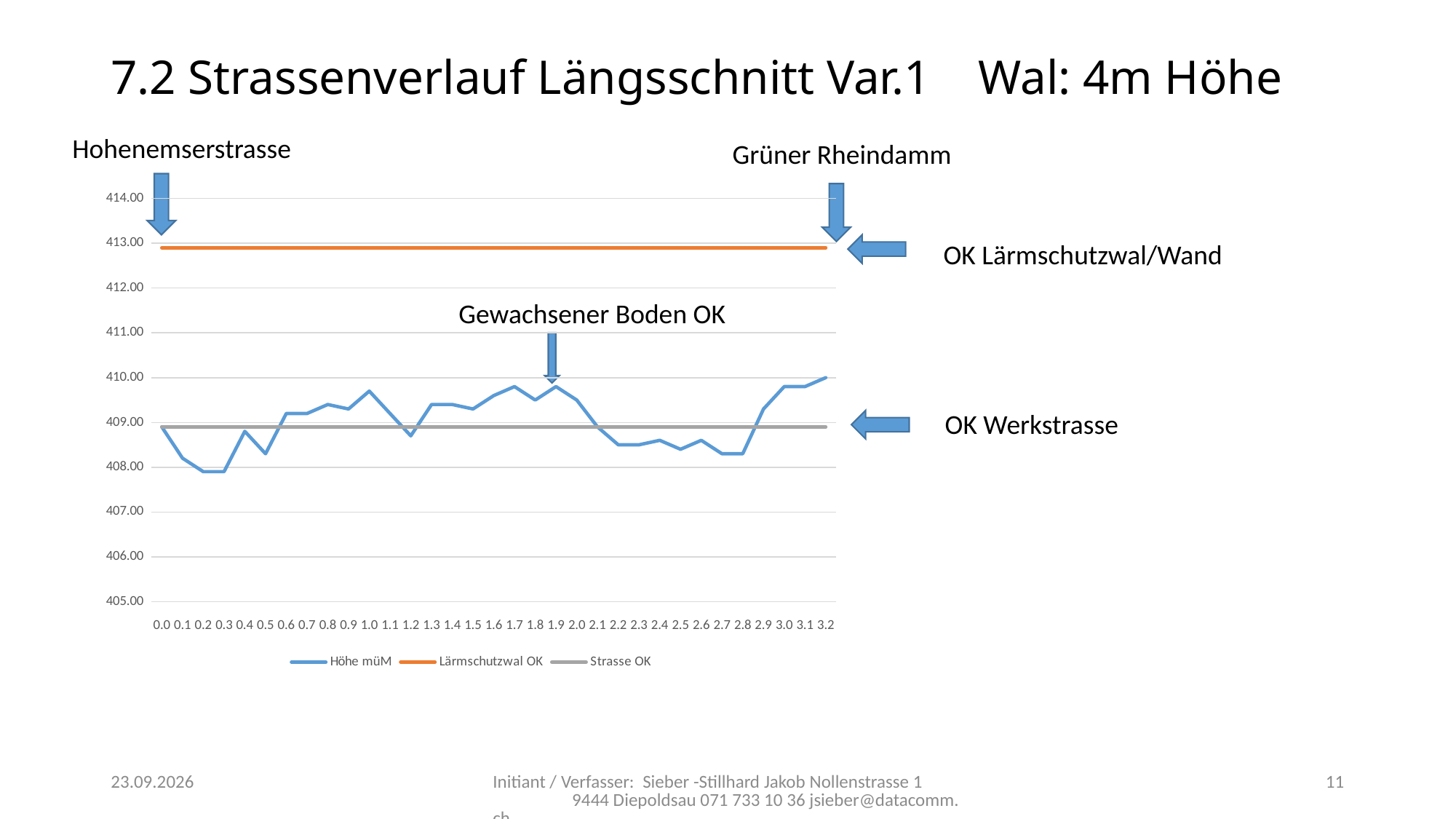
How many series does the chart legend list? 3 At x = 1.0, which is larger: Höhe müM or Strasse OK? Höhe müM Is the value of the Höhe müM series at 2.7 greater or less than 409.00? less Is the value of the Höhe müM series at 1.7 greater or less than 409.00? greater Which series lies highest on the chart across the whole x axis? Lärmschutzwal OK Is the Lärmschutzwal OK line greater or less than 412.00? greater What colour is the Lärmschutzwal OK line in the chart? orange Does the Höhe müM series rise or fall between x = 2.8 and x = 3.2? rise How many points are labelled along the x axis of the chart? 33 What kind of chart is shown on the slide? line chart At x = 2.5, which is larger: Höhe müM or Strasse OK? Strasse OK